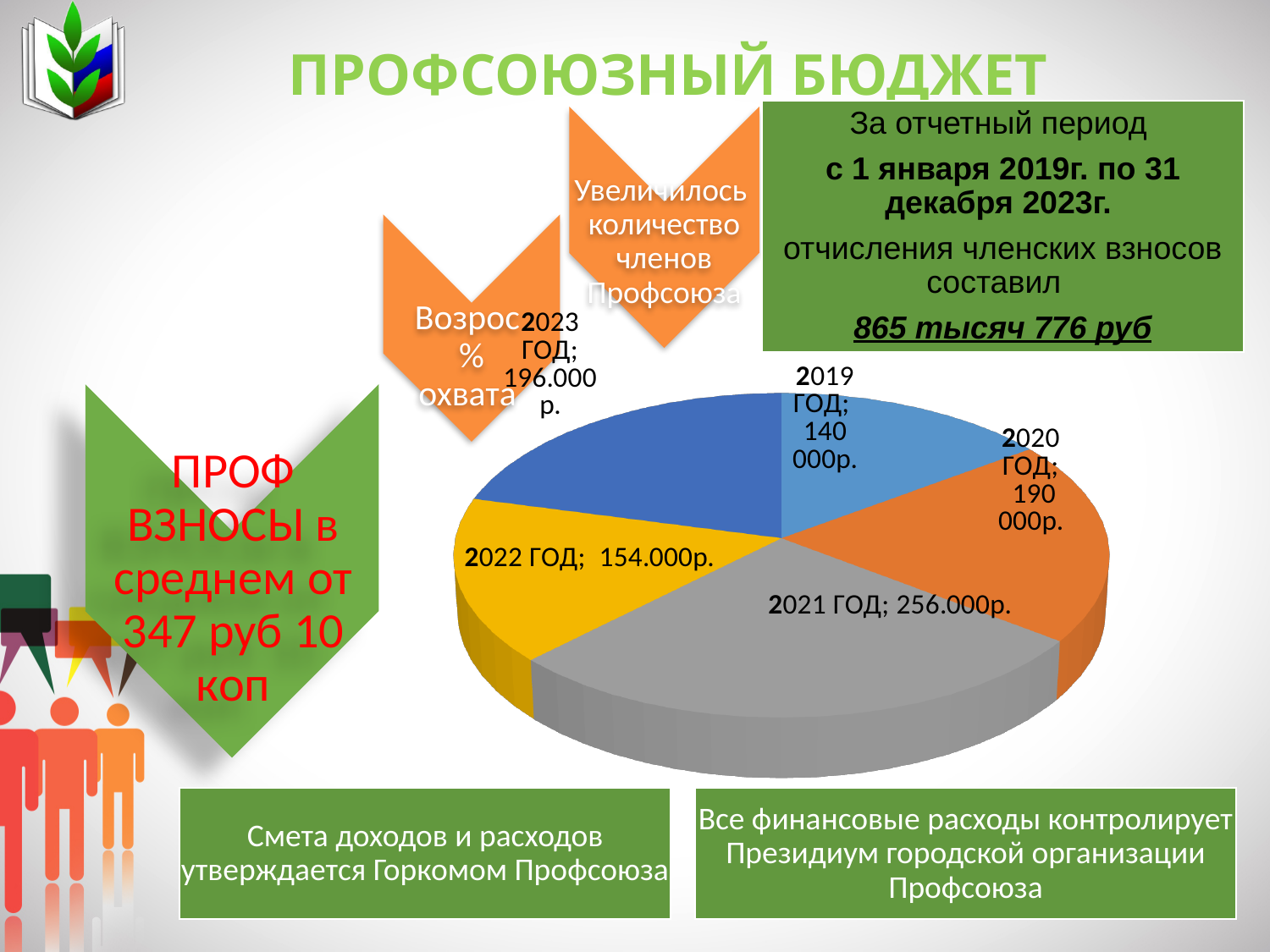
What colour is the slice for 2021 ГОД in the pie chart? Grey What is the difference between the values for 2021 ГОД and 2019 ГОД? 116 000р. Which year has the largest slice in the pie chart? 2021 ГОД What value is shown for 2021 ГОД in the pie chart? 256.000р. What is the difference between the values for 2023 ГОД and 2020 ГОД? 6 000р. What value is shown for 2023 ГОД in the pie chart? 196.000 р. Which year has the smallest slice in the pie chart? 2019 ГОД Which is larger, the value for 2020 ГОД or for 2023 ГОД? 2023 ГОД How many slices does the pie chart have? 5 What value is shown for 2019 ГОД in the pie chart? 140 000р. What value is shown for 2022 ГОД in the pie chart? 154.000р. What kind of chart is shown on the slide? Pie chart